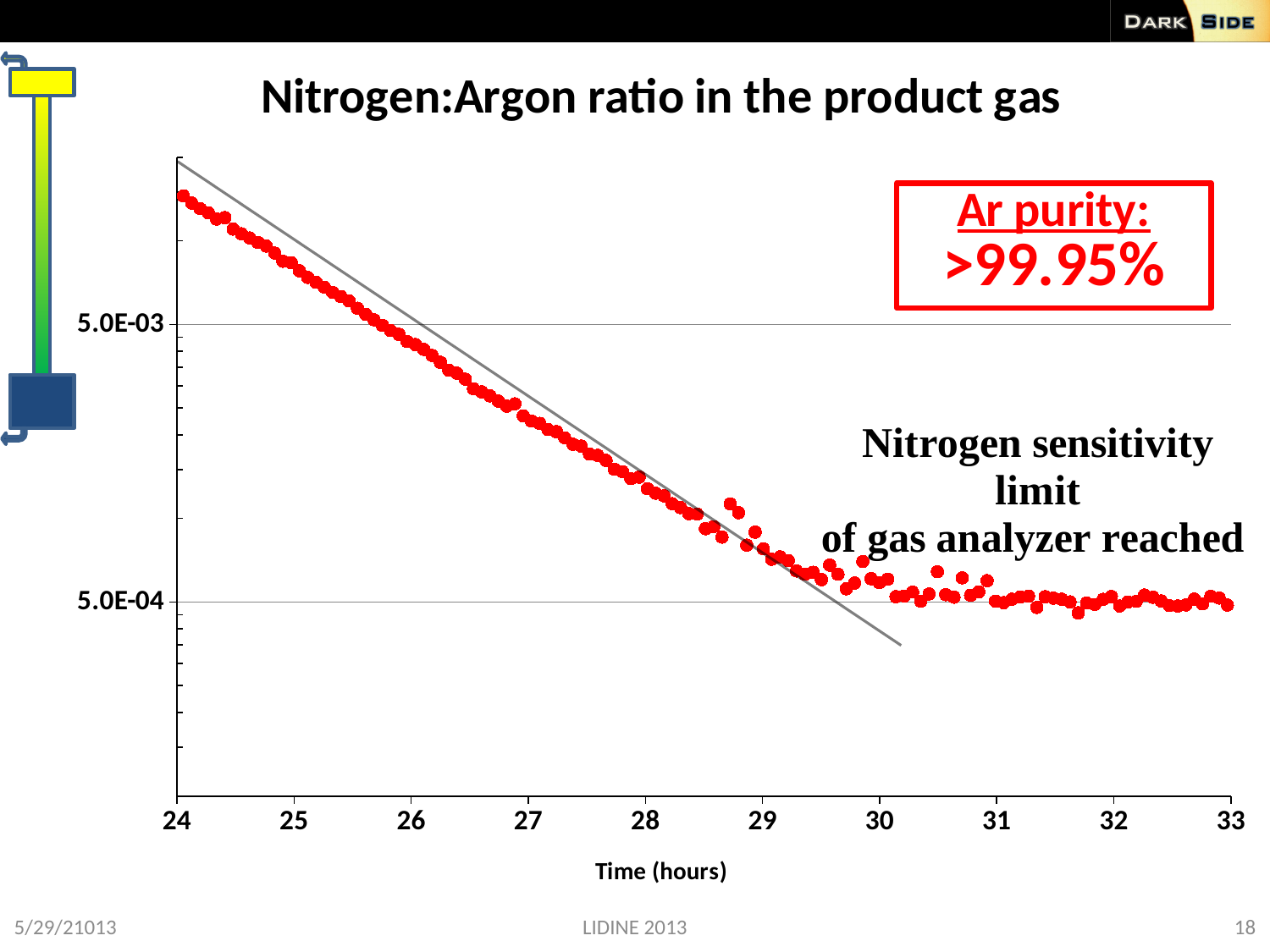
What is the title of the chart? Nitrogen:Argon ratio in the product gas Do the plotted values rise or fall as time increases from 24 to 33 hours? fall Is the Nitrogen:Argon ratio at 27 hours greater or less than 5.0E-03? less Is the Nitrogen:Argon ratio at 28 hours greater or less than 5.0E-04? greater What is the label of the x axis? Time (hours) Is the Nitrogen:Argon ratio at 33 hours greater or less than 5.0E-03? less Which is larger, the Nitrogen:Argon ratio at 26 hours or at 29 hours? 26 hours What kind of chart is shown on the slide? scatter chart Which is larger, the Nitrogen:Argon ratio at 25 hours or at 30 hours? 25 hours